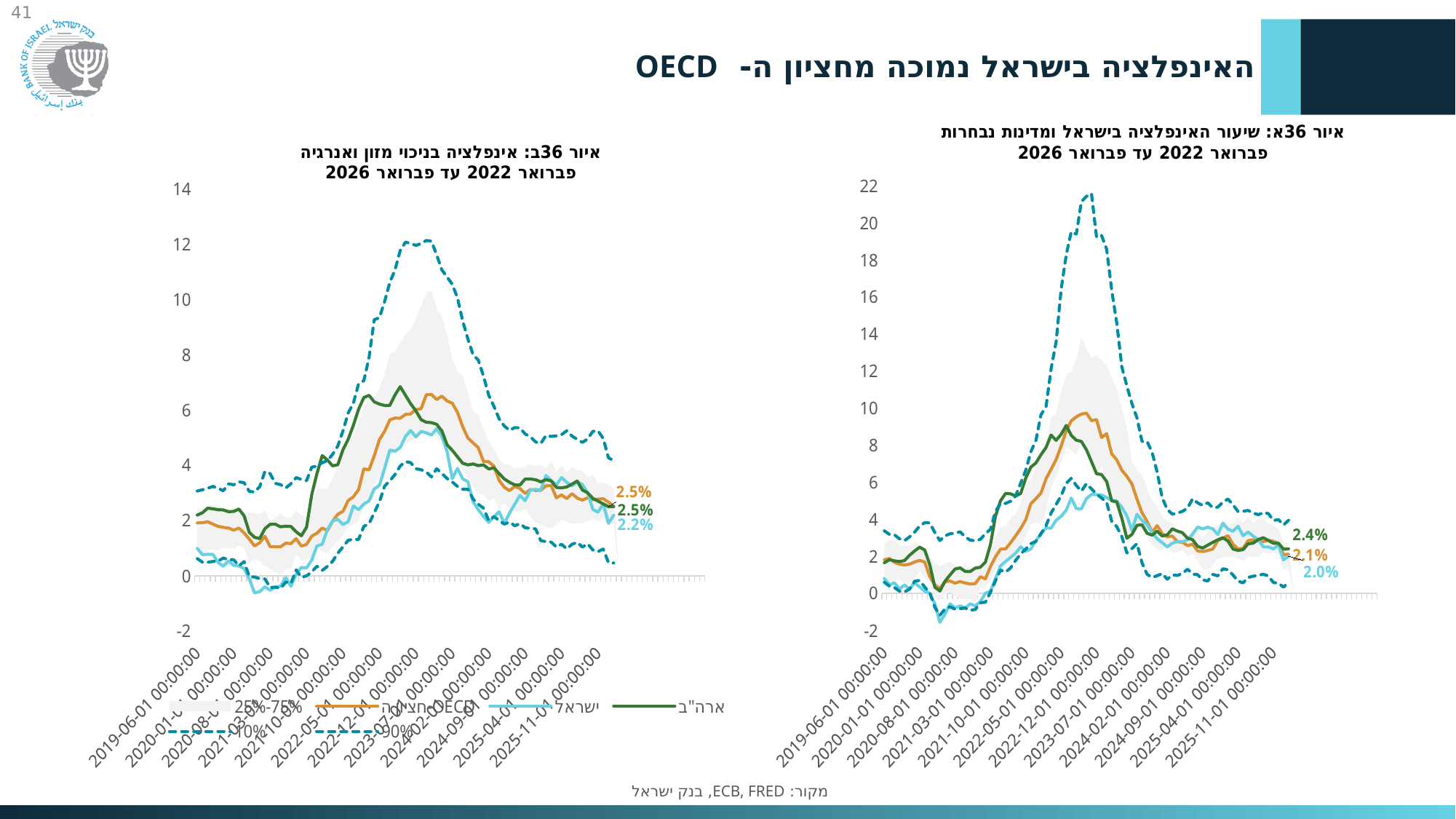
In the left chart (איור 36ב), what is the final value labelled for the light-blue line (ישראל)? 2.2% In the right chart (איור 36א), what is the difference between the labelled end values for ארה"ב and ישראל? 0.4% What type of chart is shown on the left (איור 36ב)? line chart In the right chart (איור 36א), is the peak of the green line (ארה"ב) greater or less than 8? greater In the right chart (איור 36א), what is the final value labelled for the green line (ארה"ב)? 2.4% In the right chart (איור 36א), is the peak of the upper dashed line greater or less than 20? greater In the left chart (איור 36ב), what is the final value labelled for the orange line (חציון OECD)? 2.5% In the right chart (איור 36א), do the inflation lines rise or fall from their 2022–2023 peak toward the end of the series? fall In the right chart (איור 36א), what is the final value labelled for the orange line (חציון OECD)? 2.1% In the right chart (איור 36א), what is the final value labelled for the light-blue line (ישראל)? 2.0% In the right chart (איור 36א), which of the three labelled end values is the lowest? ישראל (2.0%) In the left chart (איור 36ב), is the labelled end value for ישראל larger or smaller than that for חציון OECD? smaller